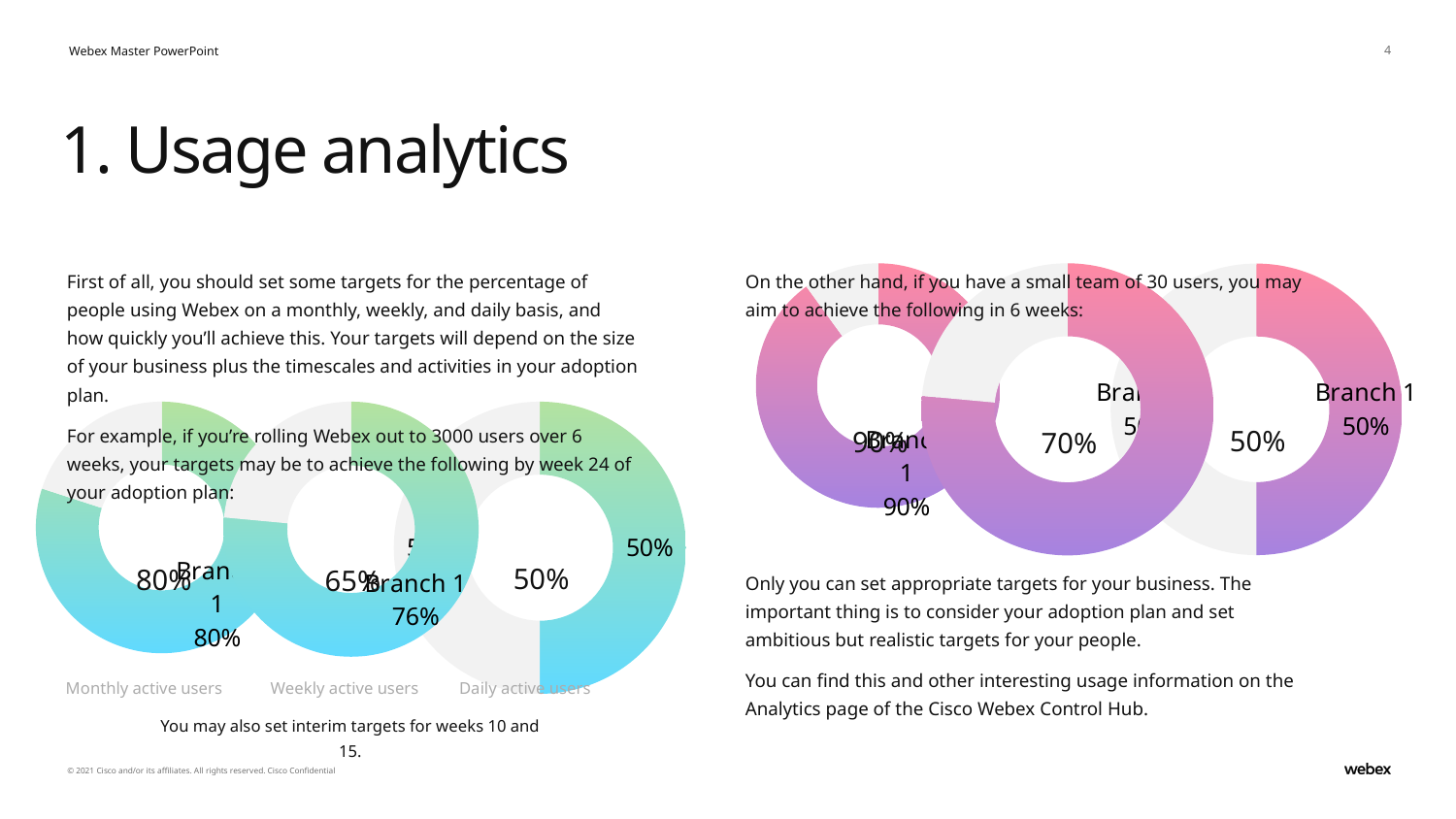
In the right-hand group of charts, what value is shown in the centre of the third (daily) donut? 50% In the left-hand group of charts, which is larger: the Monthly active users value or the Daily active users value? Monthly active users Is the value shown in the left-hand Weekly active users donut greater or less than 50%? greater How many donut charts are shown on the slide in total? 6 In the left-hand group of charts, what is the difference between the Monthly active users value (80%) and the Daily active users value (50%)? 30 percentage points What kind of chart is used for the usage targets on this slide? Donut (pie) chart In the left-hand group of charts, what value is shown in the centre of the Daily active users donut? 50% What are the three captions printed beneath the left-hand group of donut charts? Monthly active users, Weekly active users, Daily active users Which monthly target is higher: the one for 3000 users (left charts) or the one for the small team of 30 users (right charts)? The small team of 30 users (90%) In the right-hand group of charts (small team of 30 users), what value is shown in the centre of the first (monthly) donut? 90% In the left-hand group of charts (3000 users over 6 weeks), what value is shown in the centre of the Monthly active users donut? 80% In the right-hand group of charts, what value is shown in the centre of the middle (weekly) donut? 70%